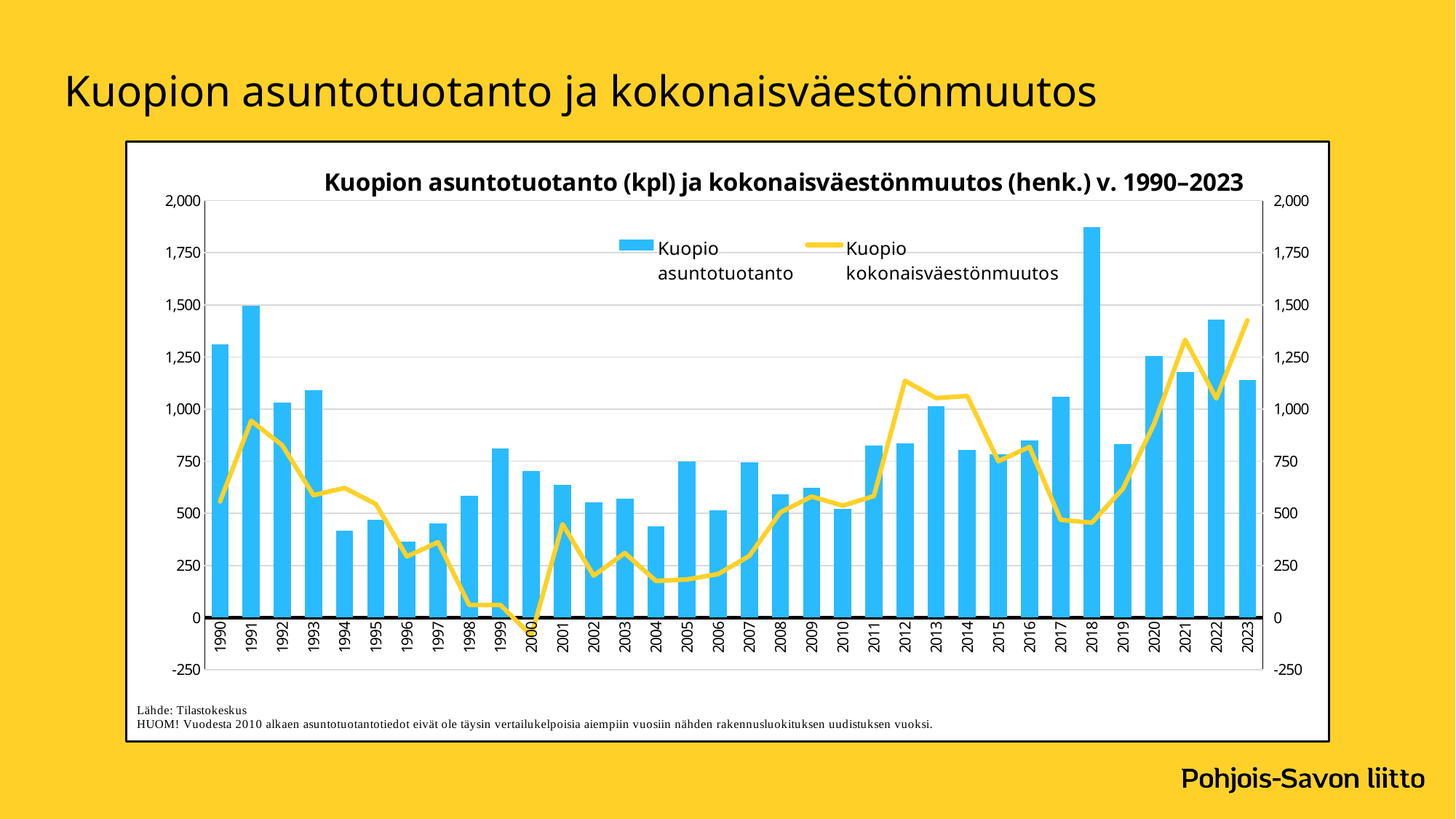
Is the Kuopio asuntotuotanto value for 2018 greater or less than 1,750? greater How many series does the legend list? 2 Which year has the larger Kuopio asuntotuotanto bar, 1990 or 1991? 1991 Is the Kuopio kokonaisväestönmuutos value for 2012 greater or less than 1,000? greater In which year is the Kuopio kokonaisväestönmuutos line at its lowest point? 2000 Is the Kuopio asuntotuotanto value for 1994 greater or less than 500? less How many years are shown on the x axis? 34 What colour is the Kuopio kokonaisväestönmuutos line? Yellow In which year is the Kuopio asuntotuotanto bar the lowest? 1996 In which year is the Kuopio asuntotuotanto bar the highest? 2018 What kind of chart is shown on the slide? A combined bar and line chart